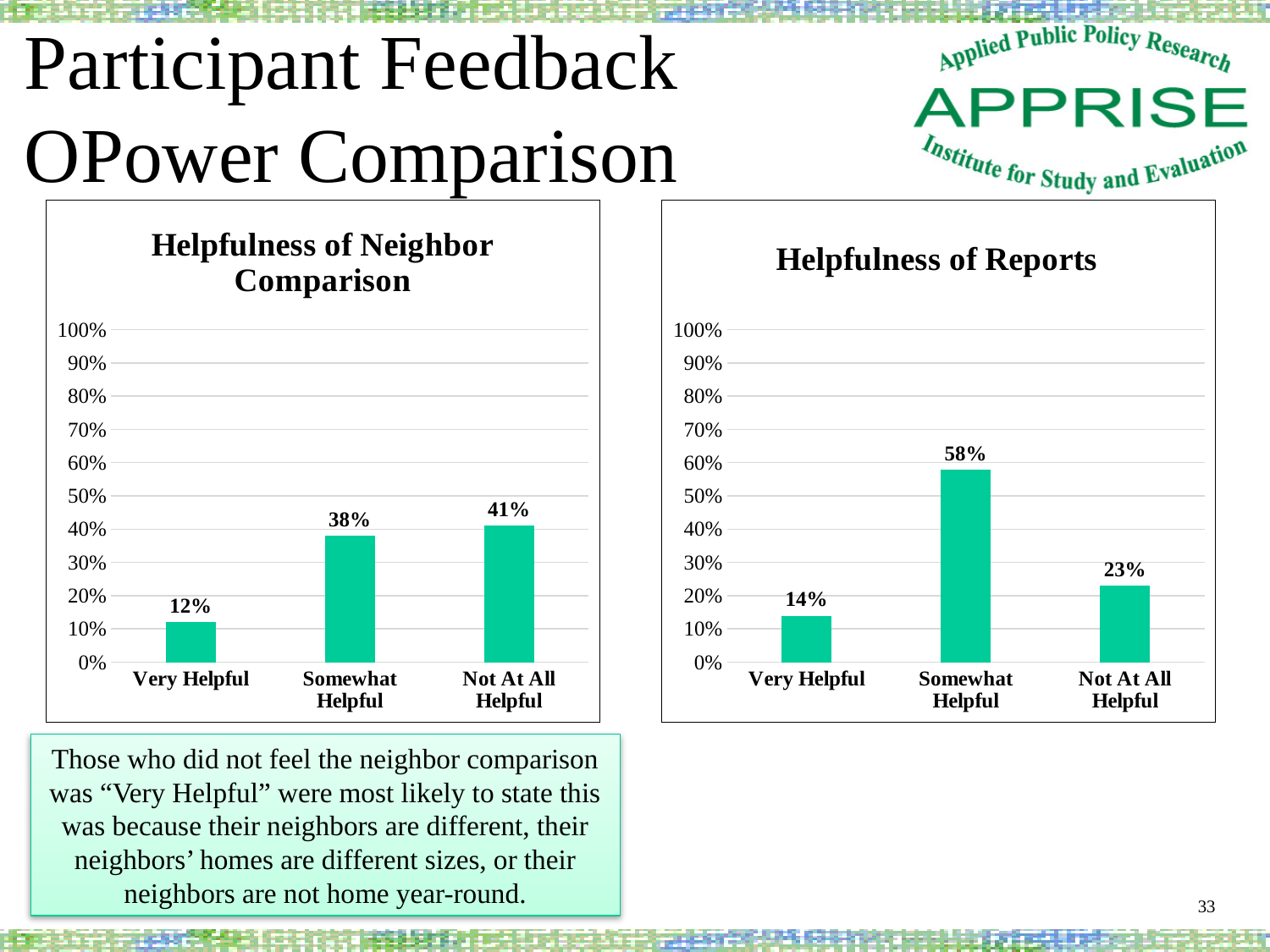
What kind of chart is the "Helpfulness of Reports" chart? Bar chart In the "Helpfulness of Reports" chart, what is the value for Not At All Helpful? 23% In the "Helpfulness of Neighbor Comparison" chart, what is the value for Very Helpful? 12% In the "Helpfulness of Reports" chart, is the value for Somewhat Helpful greater or less than 50%? greater In the "Helpfulness of Reports" chart, what is the difference between Somewhat Helpful and Not At All Helpful? 35% In the "Helpfulness of Neighbor Comparison" chart, what is the value for Not At All Helpful? 41% How many categories are shown in the "Helpfulness of Neighbor Comparison" chart? 3 In the "Helpfulness of Neighbor Comparison" chart, which category has the highest value? Not At All Helpful In the "Helpfulness of Neighbor Comparison" chart, what is the difference between Somewhat Helpful and Very Helpful? 26% In the "Helpfulness of Reports" chart, which category has the lowest value? Very Helpful Which is larger: Very Helpful in the "Helpfulness of Neighbor Comparison" chart or Very Helpful in the "Helpfulness of Reports" chart? Helpfulness of Reports In the "Helpfulness of Reports" chart, what is the value for Somewhat Helpful? 58%